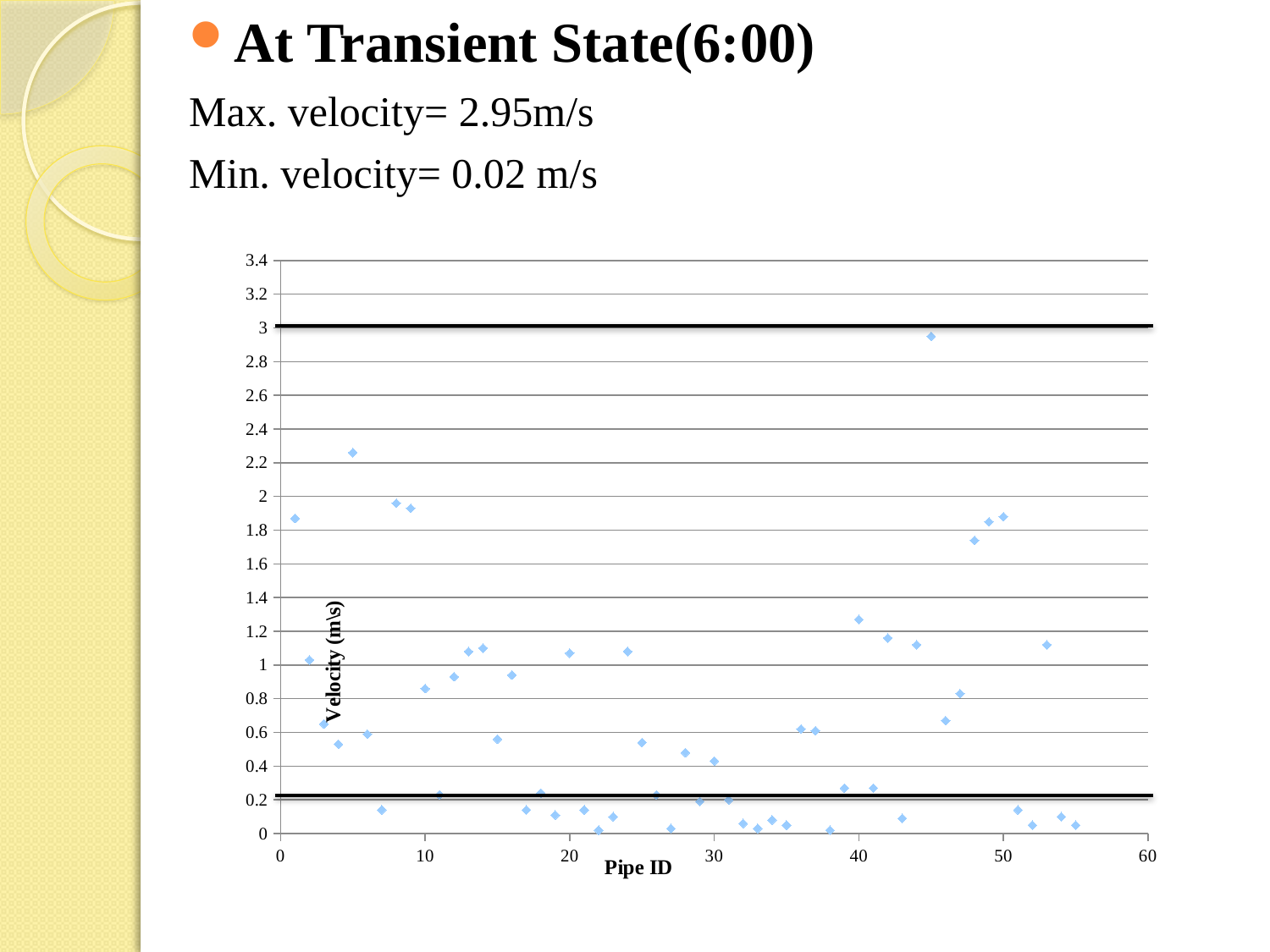
According to the slide, what is the minimum velocity at the transient state (6:00)? 0.02 m/s Is the velocity for pipe ID 10 greater or less than 0.8? greater Between which two x-axis ticks does the highest velocity point fall? 40 and 50 Is the velocity for pipe ID 40 greater or less than 1.2? greater Which has the higher velocity, pipe ID 5 or pipe ID 10? pipe ID 5 What kind of chart is shown on the slide? scatter chart Is the velocity for pipe ID 30 greater or less than 0.6? less What is the y-axis title of the chart? Velocity (m\s) According to the slide, what is the maximum velocity at the transient state (6:00)? 2.95m/s What is the x-axis title of the chart? Pipe ID